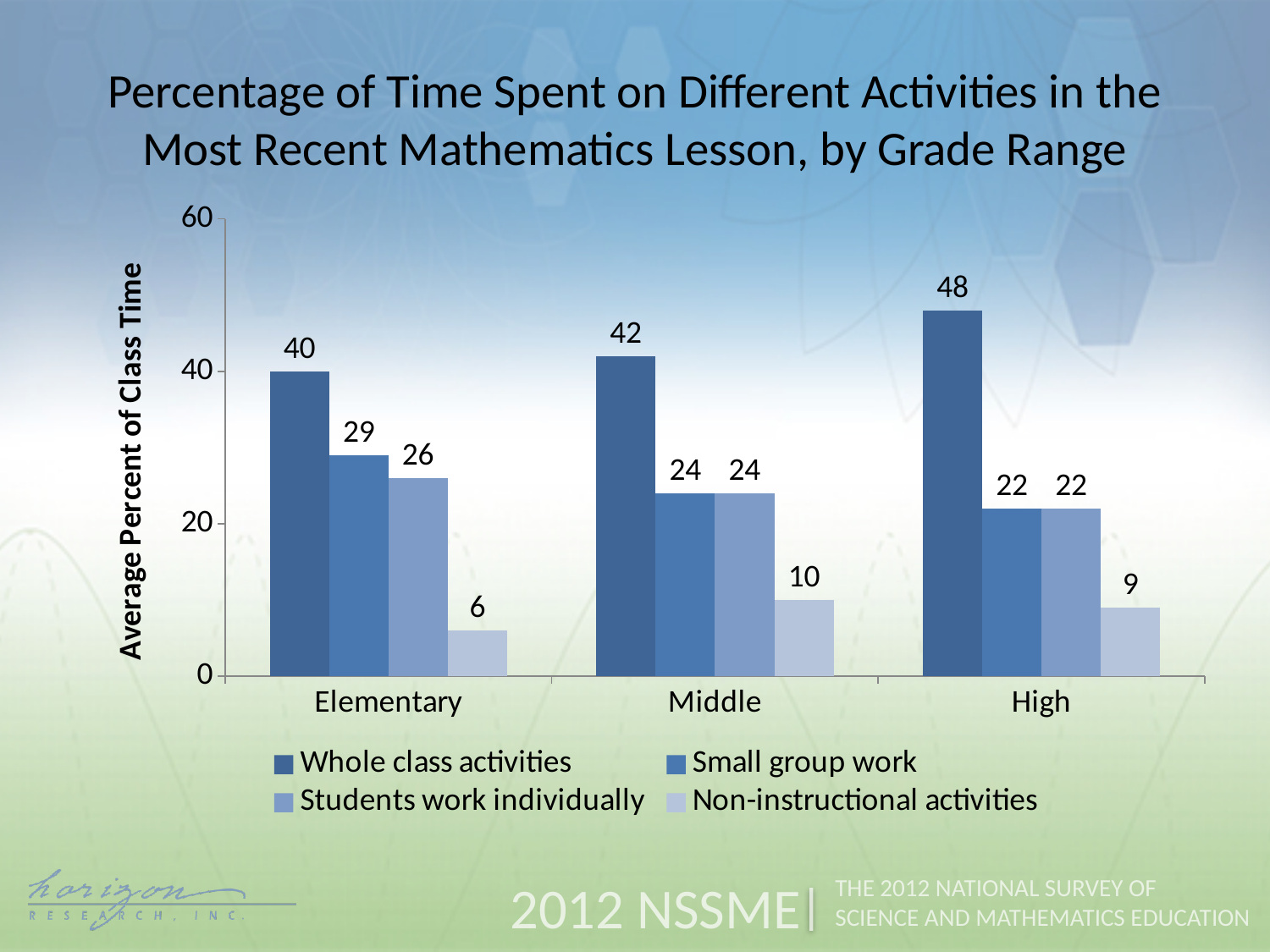
What is the value for Non-instructional activities in the Middle grade range? 10 What is the value for Small group work in the High grade range? 22 Which grade range has the highest value for Whole class activities? High What kind of chart is shown on the slide? Bar chart Is the value for Whole class activities in the Middle grade range greater or less than 40? greater What is the value for Whole class activities in the Elementary grade range? 40 How many series does the legend list? 4 What is the label of the y axis? Average Percent of Class Time Which is larger: Small group work for Elementary or Small group work for Middle? Small group work for Elementary How many grade ranges are shown on the x axis? 3 What is the difference between Whole class activities and Small group work in the High grade range? 26 Which grade range has the lowest value for Non-instructional activities? Elementary